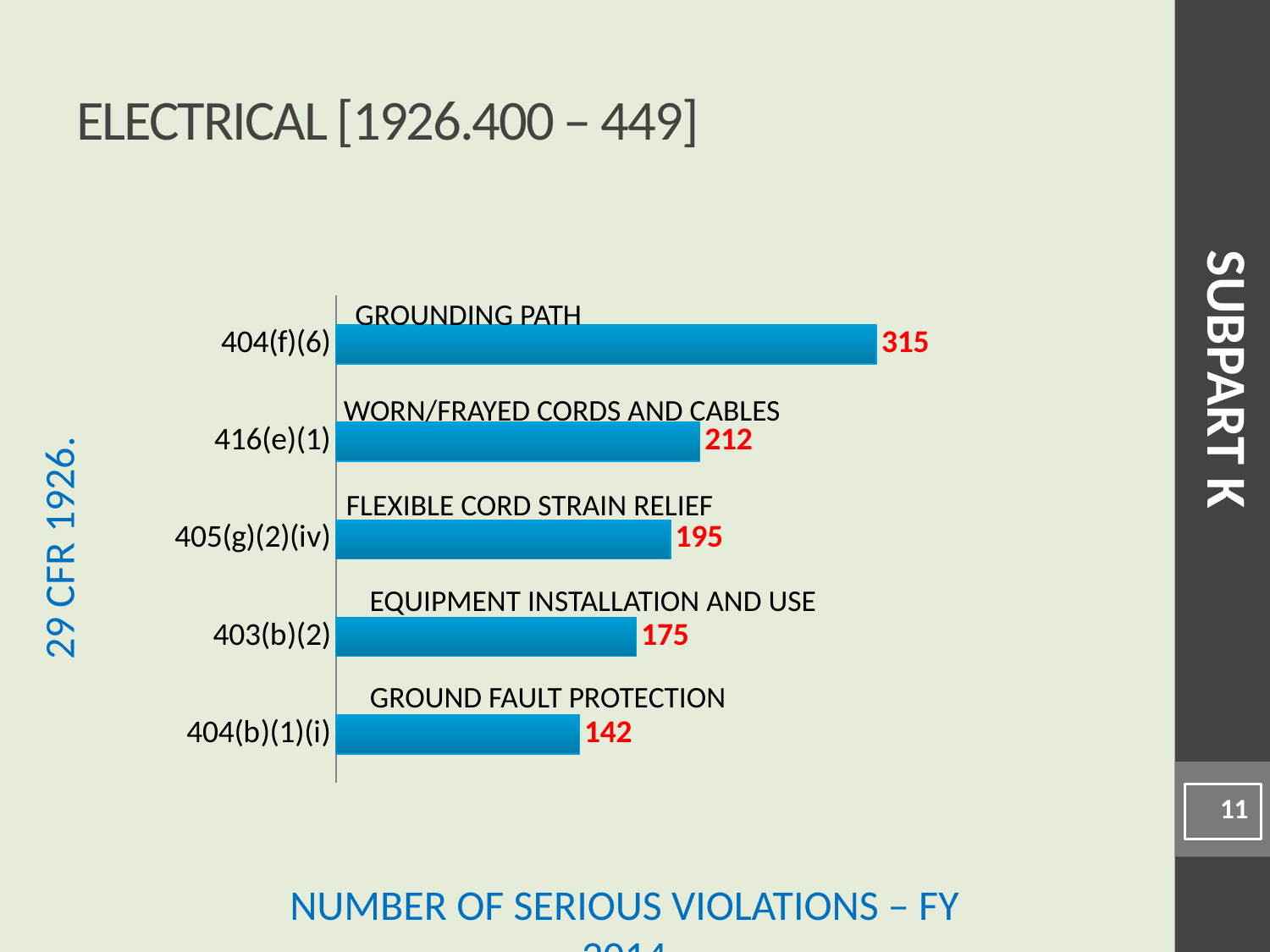
What is the number of serious violations for 405(g)(2)(iv) (Flexible Cord Strain Relief)? 195 What kind of chart is shown on the slide? Bar chart What is the number of serious violations for 404(f)(6) (Grounding Path)? 315 What is the difference between the violations for 404(f)(6) and 416(e)(1)? 103 What is the title of the slide? ELECTRICAL [1926.400 – 449] Which standard has the lowest number of serious violations? 404(b)(1)(i) Which standard has the highest number of serious violations? 404(f)(6) What is the number of serious violations for 404(b)(1)(i) (Ground Fault Protection)? 142 What is the difference between the violations for 403(b)(2) and 404(b)(1)(i)? 33 Which has more serious violations, 405(g)(2)(iv) or 403(b)(2)? 405(g)(2)(iv) What is the number of serious violations for 416(e)(1) (Worn/Frayed Cords and Cables)? 212 How many standards are shown in the chart? 5